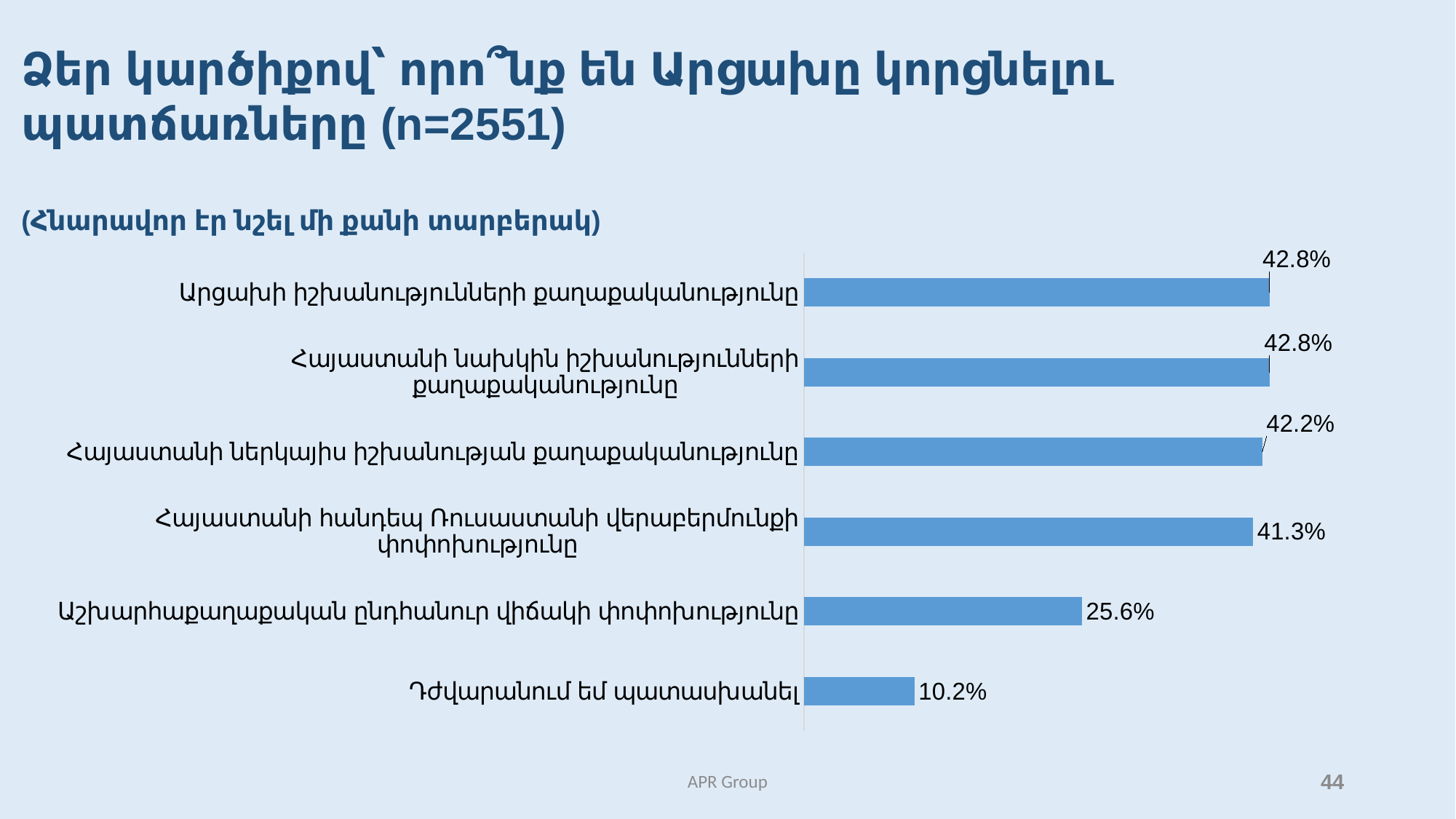
What value is shown for "Հայաստանի ներկայիս իշխանության քաղաքականությունը"? 42.2% Which is larger: the value for "Հայաստանի հանդեպ Ռուսաստանի վերաբերմունքի փոփոխությունը" or for "Աշխարհաքաղաքական ընդհանուր վիճակի փոփոխությունը"? Հայաստանի հանդեպ Ռուսաստանի վերաբերմունքի փոփոխությունը What value is shown for "Դժվարանում եմ պատասխանել"? 10.2% What is the sample size (n) stated in the slide title? 2551 What percentage is shown for "Աշխարհաքաղաքական ընդհանուր վիճակի փոփոխությունը"? 25.6% What kind of chart is shown on the slide? Bar chart What percentage is shown for "Հայաստանի հանդեպ Ռուսաստանի վերաբերմունքի փոփոխությունը"? 41.3% What percentage is shown for "Արցախի իշխանությունների քաղաքականությունը"? 42.8% How many categories are shown in the chart? 6 What is the difference between the values for "Հայաստանի ներկայիս իշխանության քաղաքականությունը" and "Դժվարանում եմ պատասխանել"? 32.0% What is the difference between the values for "Հայաստանի նախկին իշխանությունների քաղաքականությունը" and "Աշխարհաքաղաքական ընդհանուր վիճակի փոփոխությունը"? 17.2% Which category has the lowest value in the chart? Դժվարանում եմ պատասխանել